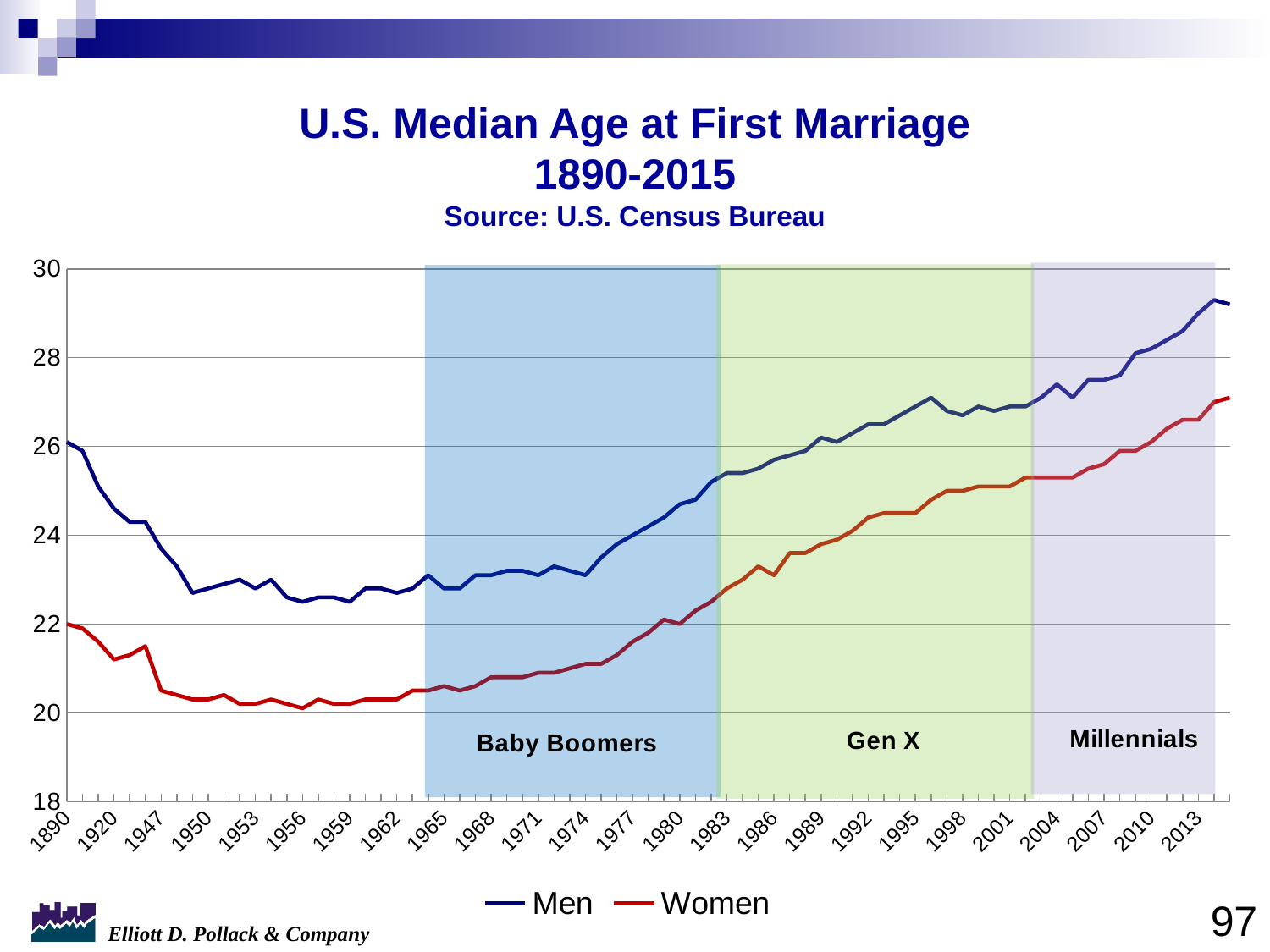
Is the value for Men in 2013 greater or less than 28? greater Is the value for Men in 1950 greater or less than 24? less What is the title of the chart? U.S. Median Age at First Marriage 1890-2015 What are the three generation labels shown in the shaded regions of the chart? Baby Boomers, Gen X, Millennials What kind of chart is shown on the slide? Line chart Is the value for Women in 2013 greater or less than 26? greater Does the Men series rise or fall from 1965 to 2013? Rise Does the Women series rise or fall from 1890 to 1956? Fall How many series does the legend list? 2 In 1890, which series has the higher median age, Men or Women? Men